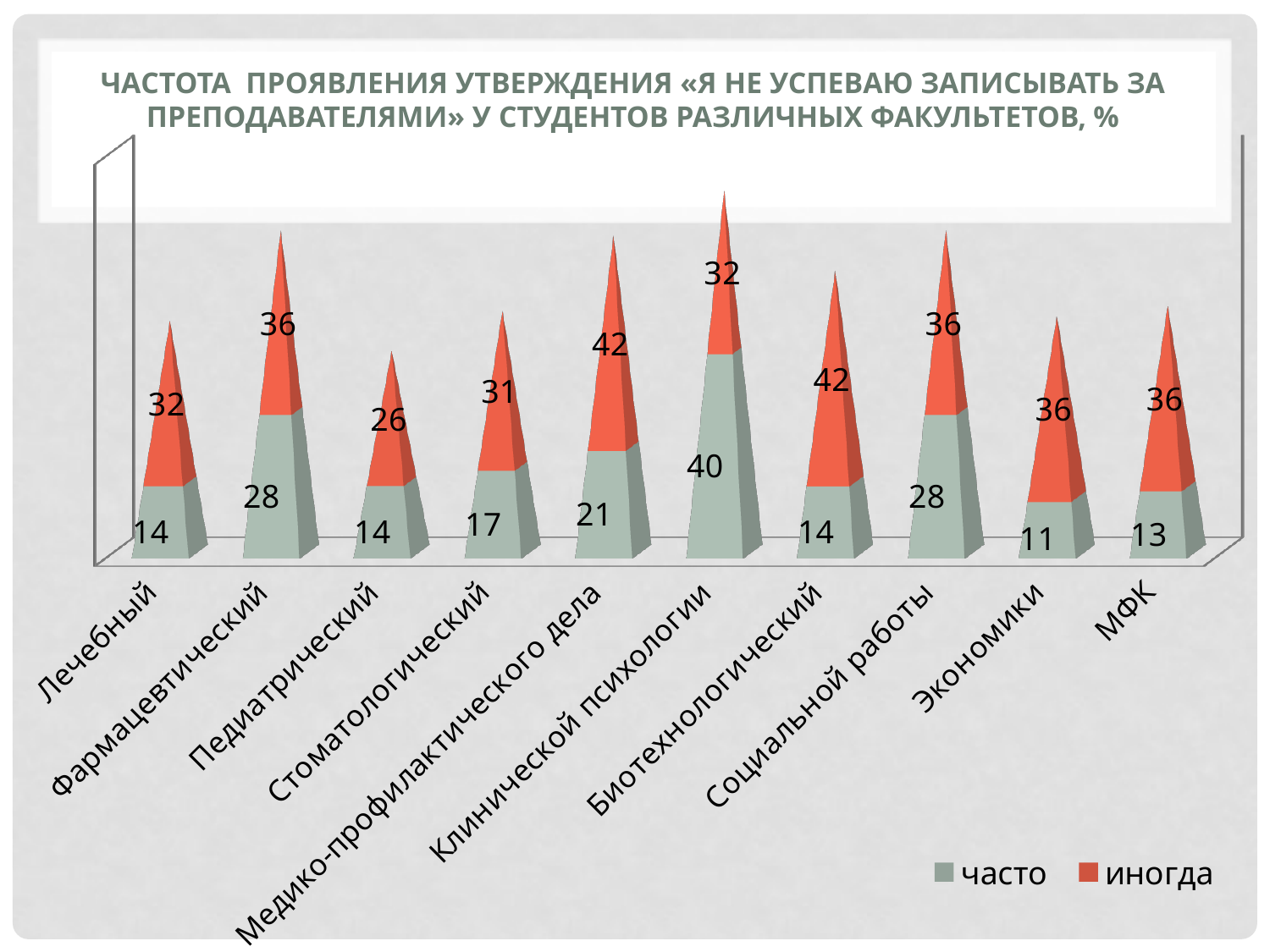
What kind of chart is shown on the slide? Stacked bar chart What is the value of «иногда» for Биотехнологический? 42 How many series does the legend list? 2 What is the value of «часто» for Экономики? 11 How many faculties are shown on the x axis? 10 Which faculty has the highest value for «часто»? Клинической психологии Which faculty has the lowest value for «часто»? Экономики What is the difference between the «иногда» and «часто» values for Лечебный? 18 Which faculty has the lowest value for «иногда»? Педиатрический What is the value of «часто» for Клинической психологии? 40 What is the total of the stacked bar for Медико-профилактического дела? 63 Which is larger: the «часто» value for Фармацевтический or for Стоматологический? Фармацевтический